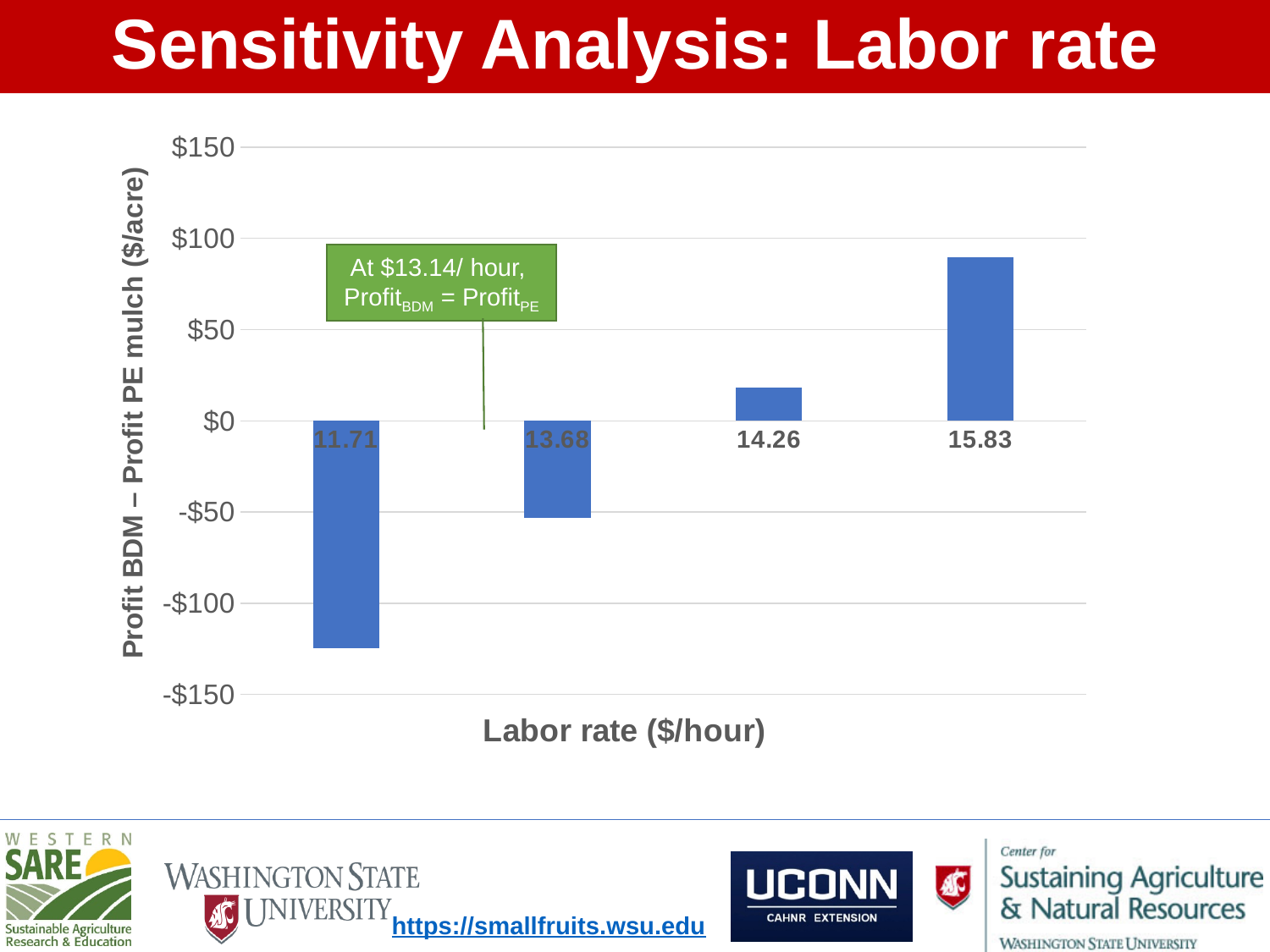
Is the value for the 15.83 labor rate greater or less than $50? greater How many labor rate categories are plotted in the chart? 4 Do the values rise or fall as the labor rate increases along the x axis? Rise Is the value for the 11.71 labor rate greater or less than -$100? less What is the title of the x axis of the chart? Labor rate ($/hour) Is the value for the 15.83 labor rate greater or less than $100? less Which labor rate has the lowest value of Profit BDM – Profit PE mulch? 11.71 According to the annotation on the chart, at what labor rate does Profit BDM equal Profit PE? $13.14/ hour What kind of chart is shown on the slide? Bar chart Which labor rate has the highest value of Profit BDM – Profit PE mulch? 15.83 Which has the larger value, the 13.68 labor rate or the 14.26 labor rate? 14.26